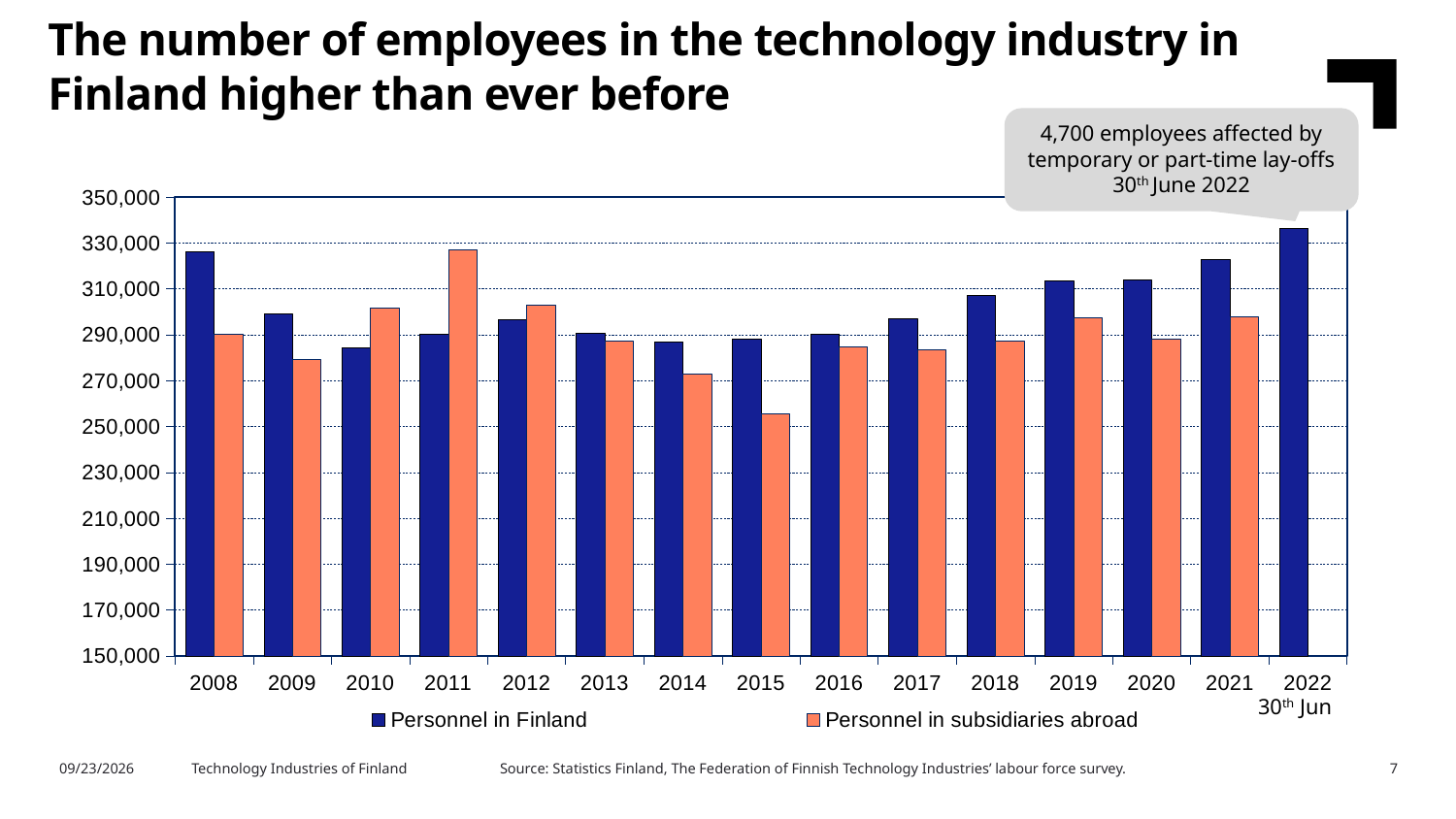
In which year is Personnel in subsidiaries abroad lowest? 2015 How many series does the legend list? 2 In 2011, which is larger: Personnel in Finland or Personnel in subsidiaries abroad? Personnel in subsidiaries abroad Does Personnel in Finland rise or fall from 2015 to 2022? rise Which colour represents Personnel in subsidiaries abroad? orange In which year is Personnel in Finland highest? 2022 How many years are shown on the x axis? 15 Is the value for Personnel in Finland in 2022 greater or less than 330,000? greater In 2020, which is larger: Personnel in Finland or Personnel in subsidiaries abroad? Personnel in Finland In which year is Personnel in subsidiaries abroad highest? 2011 Is the value for Personnel in subsidiaries abroad in 2015 greater or less than 270,000? less What kind of chart is shown on the slide? bar chart